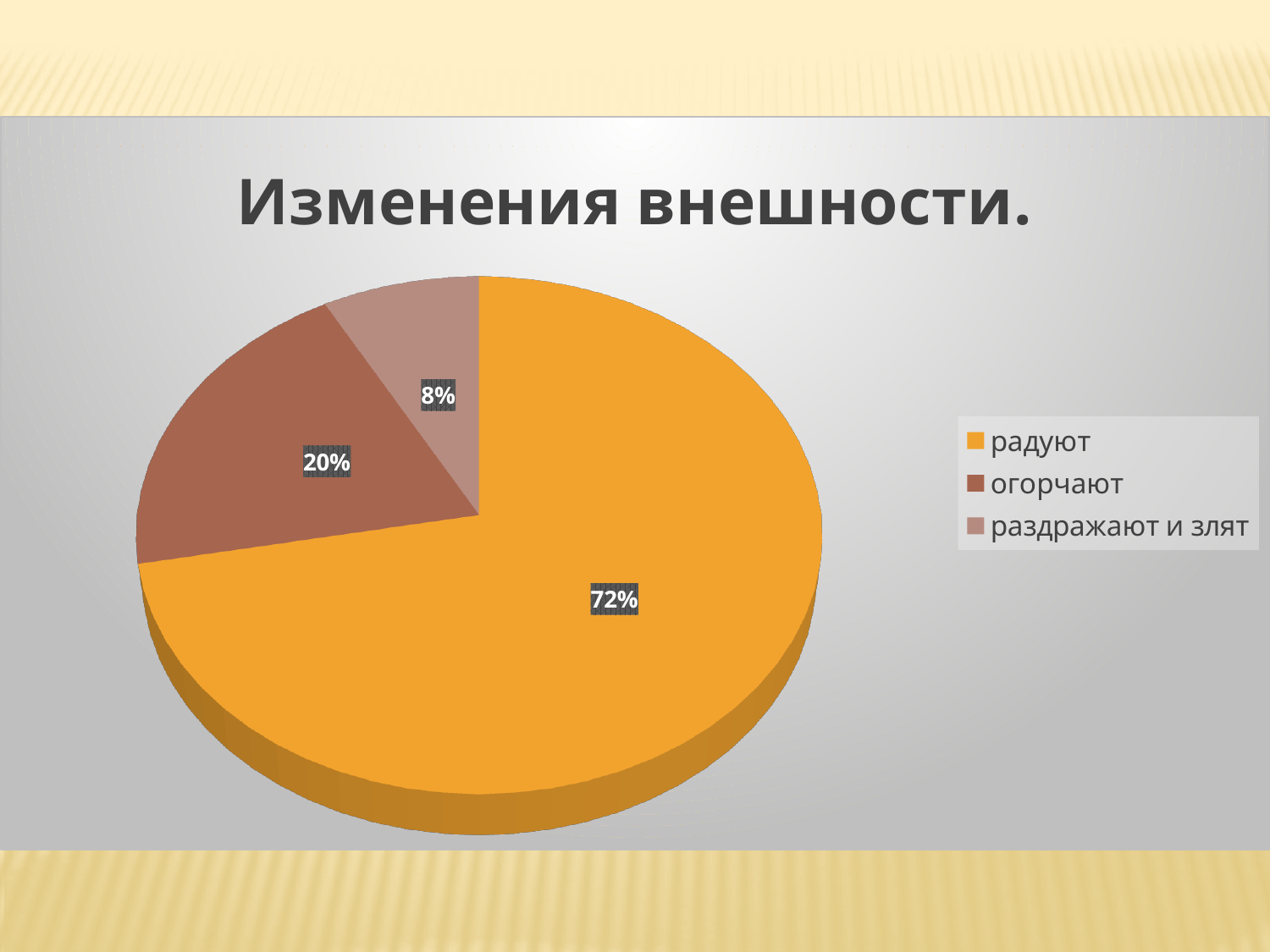
What colour is the 'радуют' slice in the pie chart? orange What share of the pie does the 'огорчают' slice represent? 20% Which category has the largest slice of the pie? радуют How many categories are shown in the pie chart? 3 Which category has the smallest slice of the pie? раздражают и злят Which slice is larger, 'огорчают' or 'раздражают и злят'? огорчают What share of the pie does the 'радуют' slice represent? 72% What kind of chart is shown on the slide? pie chart What share of the pie does the 'раздражают и злят' slice represent? 8% What is the difference in percentage points between the 'огорчают' and 'раздражают и злят' slices? 12 What is the title of the chart? Изменения внешности. What is the difference in percentage points between the 'радуют' and 'огорчают' slices? 52